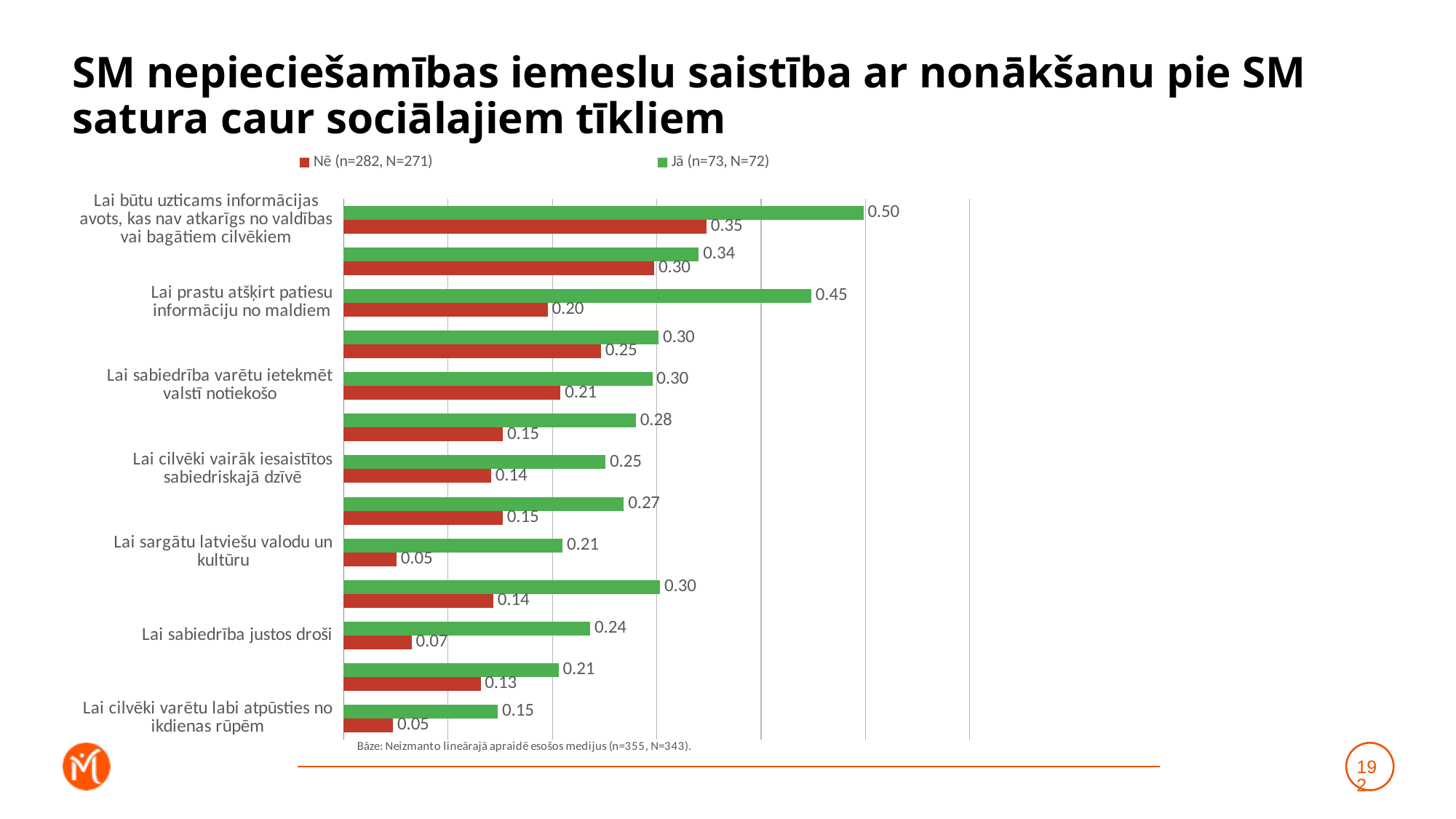
Which is larger for "Lai sabiedrība varētu ietekmēt valstī notiekošo": the Jā value or the Nē value? Jā Which is larger: the Jā value for "Lai sabiedrība justos droši" or the Jā value for "Lai cilvēki vairāk iesaistītos sabiedriskajā dzīvē"? Lai cilvēki vairāk iesaistītos sabiedriskajā dzīvē What is the difference between the Jā and Nē values for "Lai prastu atšķirt patiesu informāciju no maldiem"? 0.25 What is the value of the Nē series for "Lai prastu atšķirt patiesu informāciju no maldiem"? 0.20 What kind of chart is shown on the slide? Bar chart What is the value of the Jā series for "Lai būtu uzticams informācijas avots, kas nav atkarīgs no valdības vai bagātiem cilvēkiem"? 0.50 What colour are the bars for the Jā (n=73, N=72) series? Green What is the value of the Nē series for "Lai sargātu latviešu valodu un kultūru"? 0.05 What is the value of the Jā series for "Lai sabiedrība justos droši"? 0.24 What is the difference between the Jā and Nē values for "Lai cilvēki varētu labi atpūsties no ikdienas rūpēm"? 0.10 How many series does the legend list? 2 Which category has the highest Jā value? Lai būtu uzticams informācijas avots, kas nav atkarīgs no valdības vai bagātiem cilvēkiem